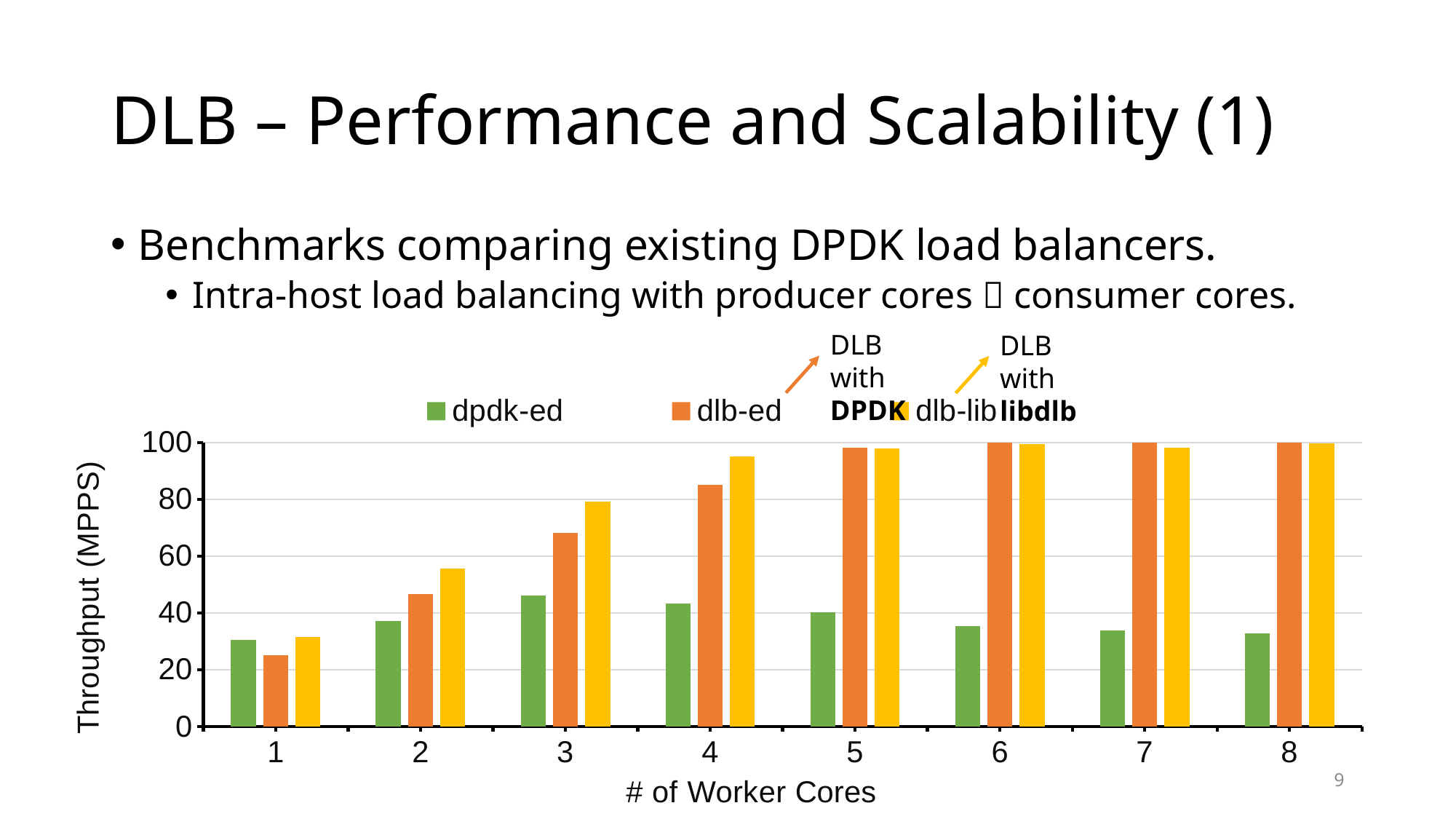
Is the dlb-ed value at 2 worker cores greater or less than 40? greater Is the dlb-lib value at 4 worker cores greater or less than 80? greater Does the dlb-ed throughput rise or fall as the number of worker cores increases from 1 to 6? rises How many series does the chart legend list? 3 Is the dpdk-ed value at 1 worker core greater or less than 40? less At 1 worker core, which is larger: dpdk-ed or dlb-ed? dpdk-ed What is the label of the y axis? Throughput (MPPS) How many worker-core categories are shown on the x axis? 8 Which series has the lowest throughput at 8 worker cores? dpdk-ed Which series has the highest throughput at 2 worker cores? dlb-lib At 3 worker cores, which is larger: dlb-ed or dlb-lib? dlb-lib What kind of chart is shown on the slide? bar chart